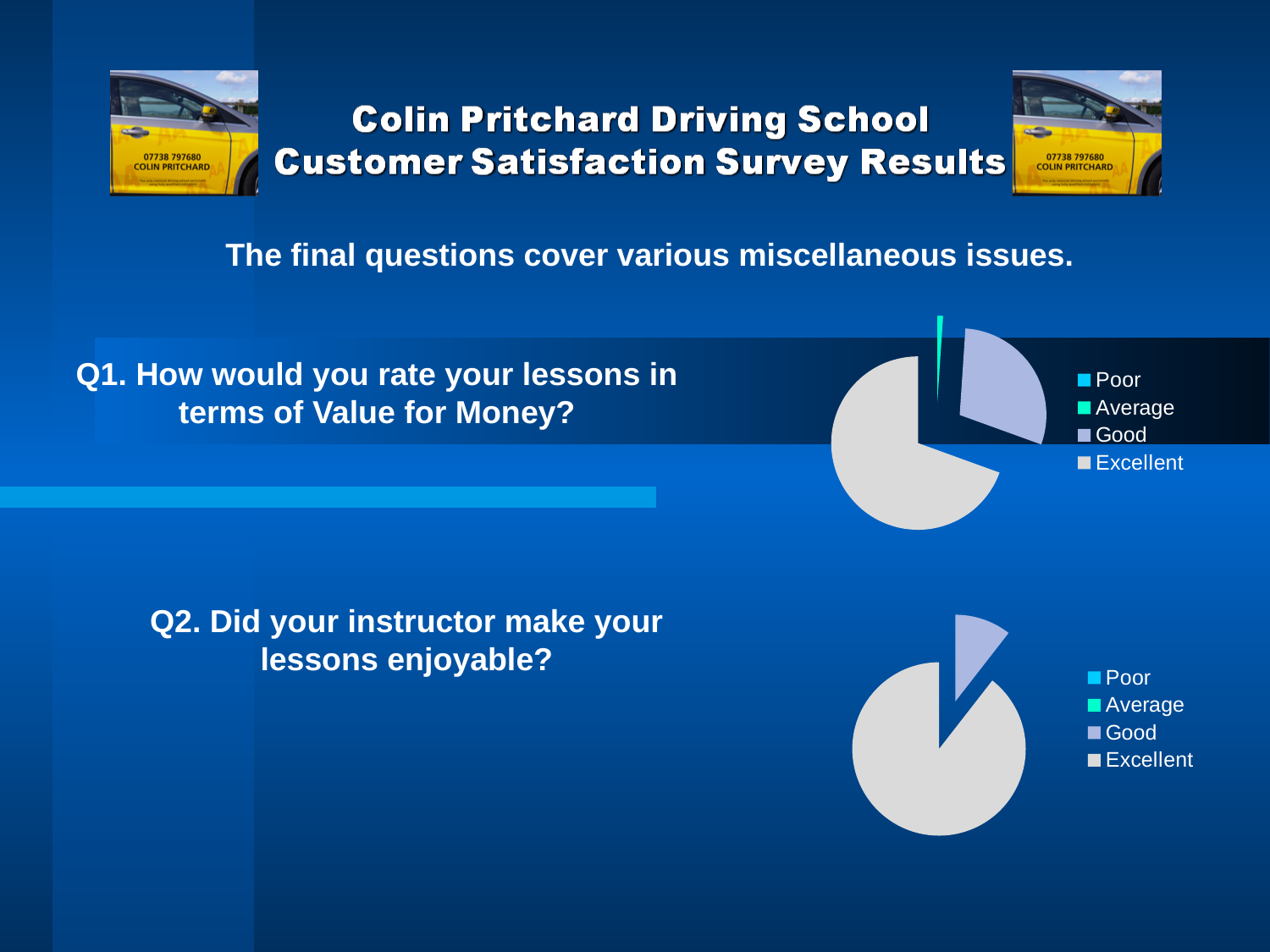
What kind of chart is used for Q2 (lessons enjoyable)? Pie chart In the Q2 lessons-enjoyable pie chart, which is larger: the Excellent slice or the Good slice? Excellent In the Q1 value-for-money pie chart, which is larger: the Good slice or the Average slice? Good In the Q2 lessons-enjoyable pie chart, which rating has the largest slice? Excellent In the Q1 value-for-money pie chart, which rating is shown as a thin cyan sliver? Average How many rating categories does the legend of the Q2 pie chart list? 4 What are the four legend entries shown for the Q2 pie chart? Poor, Average, Good, Excellent How many rating categories does the legend of the Q1 pie chart list? 4 In the Q1 value-for-money pie chart, which rating has the second-largest slice? Good In the Q1 value-for-money pie chart, which rating has the largest slice? Excellent What kind of chart is used for Q1 (value for money)? Pie chart